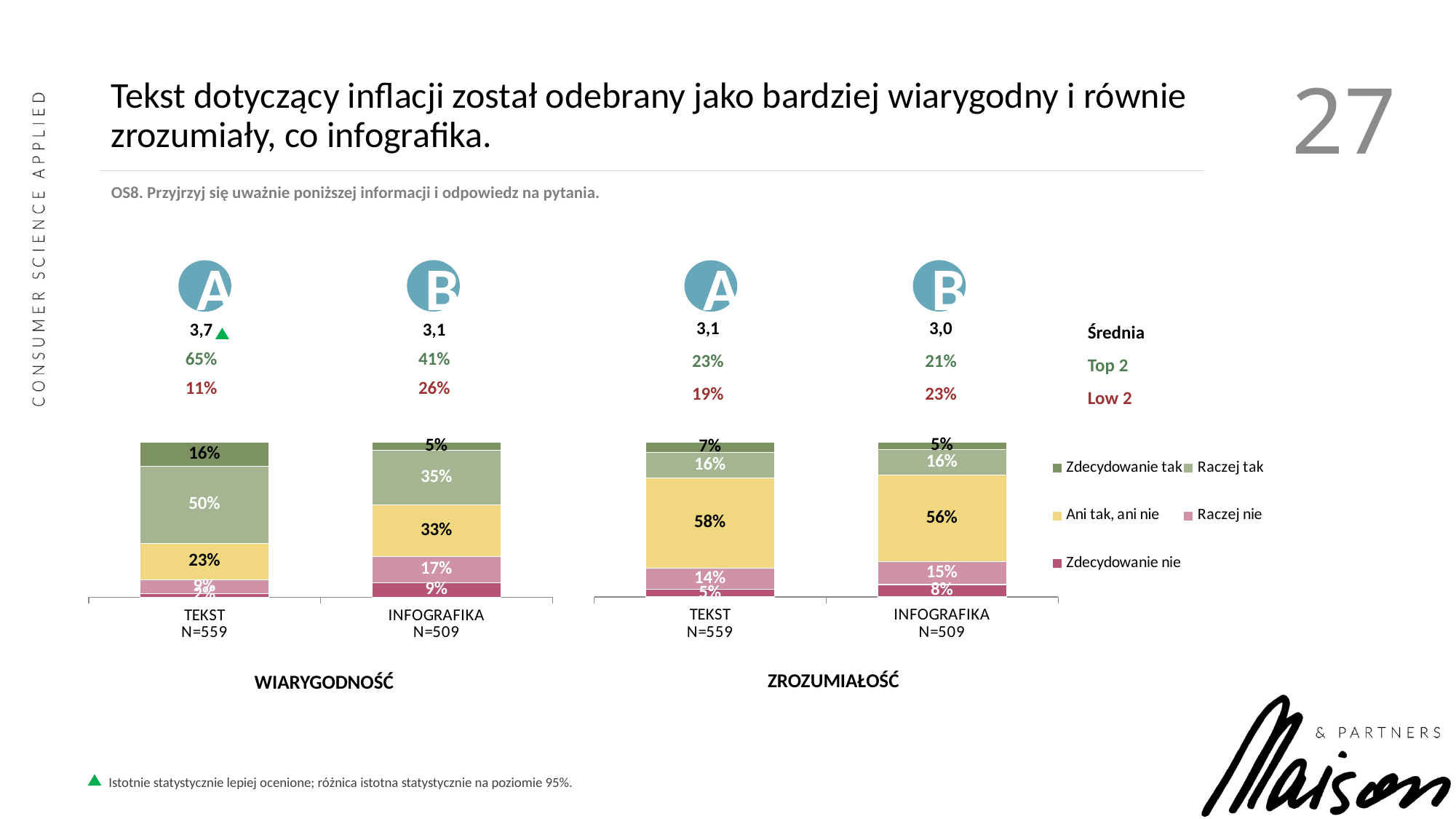
In the ZROZUMIAŁOŚĆ chart, which bar has the larger 'Ani tak, ani nie' share, TEKST or INFOGRAFIKA? TEKST What is the Top 2 value shown for INFOGRAFIKA in the ZROZUMIAŁOŚĆ chart? 21% In the WIARYGODNOŚĆ chart, which bar has the larger 'Zdecydowanie nie' share, TEKST or INFOGRAFIKA? INFOGRAFIKA What kind of chart is used for WIARYGODNOŚĆ? Stacked bar chart How many series does the legend list? 5 In the ZROZUMIAŁOŚĆ chart, what percentage of the INFOGRAFIKA bar is 'Zdecydowanie nie'? 8% In the WIARYGODNOŚĆ chart, what is the difference between the 'Zdecydowanie tak' share for TEKST and for INFOGRAFIKA? 11 percentage points In the WIARYGODNOŚĆ chart, what percentage of the TEKST bar is 'Raczej tak'? 50% In the ZROZUMIAŁOŚĆ chart, what percentage of the TEKST bar is 'Ani tak, ani nie'? 58% What is the mean (Średnia) shown for TEKST in the WIARYGODNOŚĆ chart? 3,7 How many bars are in the ZROZUMIAŁOŚĆ chart? 2 In the WIARYGODNOŚĆ chart, what percentage of the INFOGRAFIKA bar is 'Ani tak, ani nie'? 33%